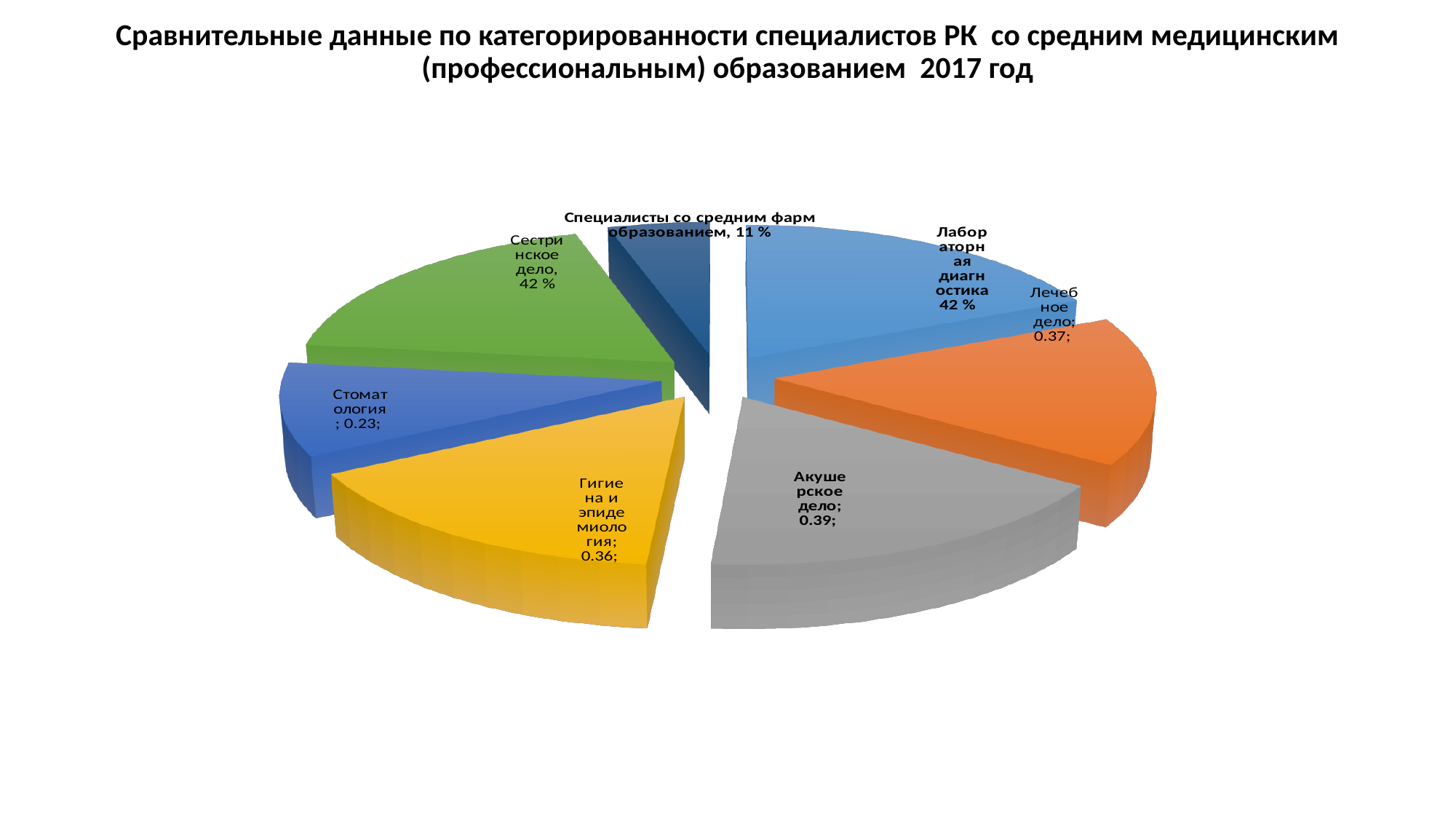
What value is labelled for Лабораторная диагностика? 42 % What value is labelled for Стоматология? 0.23 What value is labelled for Лечебное дело? 0.37 What kind of chart is shown on the slide? Pie chart What value is labelled for Специалисты со средним фарм образованием? 11 % What value is labelled for Акушерское дело? 0.39 Which year does the chart title refer to? 2017 Which has the larger labelled value, Акушерское дело or Лечебное дело? Акушерское дело What value is labelled for Сестринское дело? 42 % What value is labelled for Гигиена и эпидемиология? 0.36 How many slices does the pie chart have? 7 What is the difference between the labelled values for Акушерское дело and Стоматология? 0.16